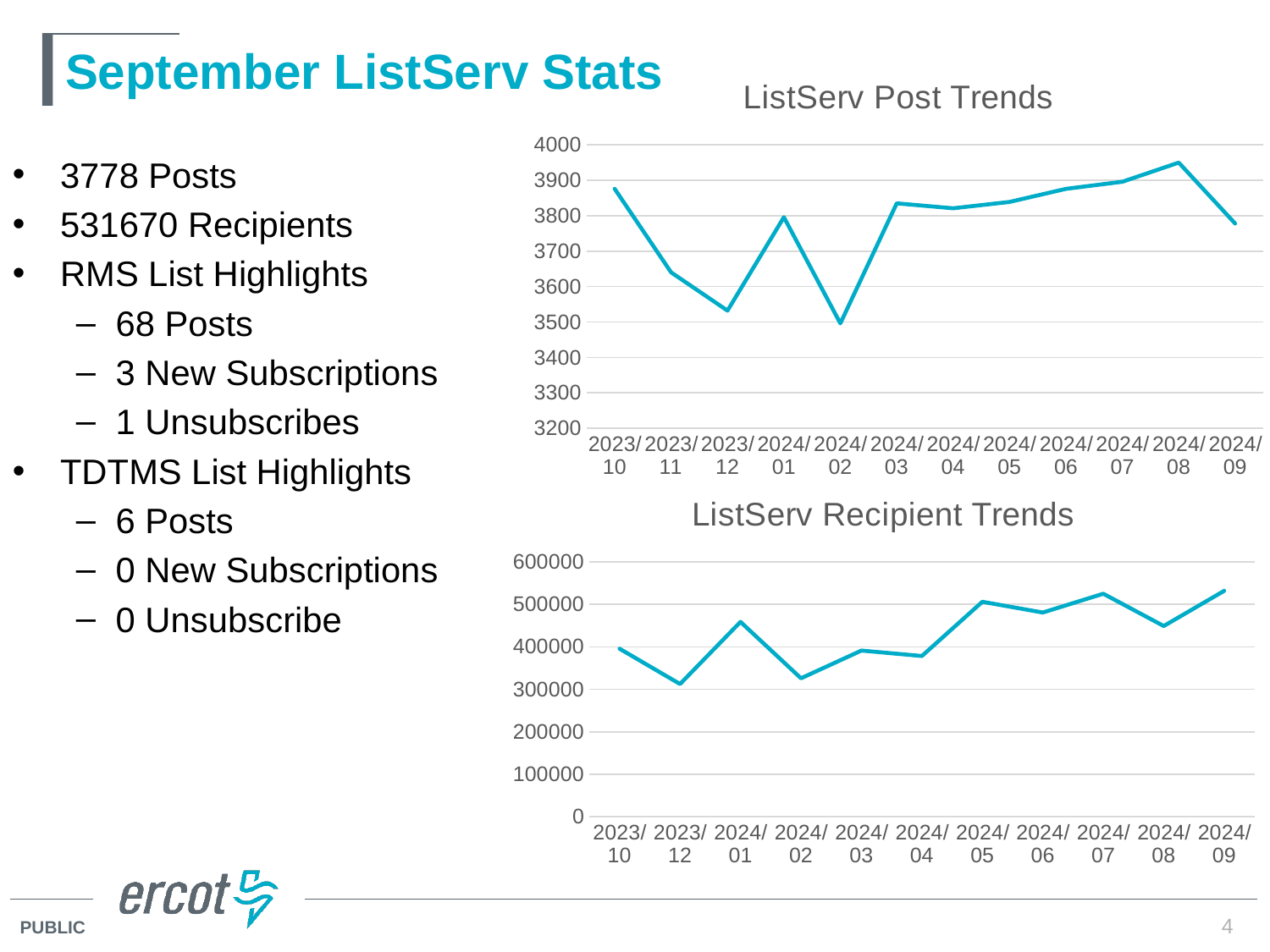
What kind of chart is the ListServ Post Trends chart? line chart In the ListServ Post Trends chart, is the value for 2024/08 greater or less than 3900? greater How many months are plotted on the x axis of the ListServ Post Trends chart? 12 In the ListServ Post Trends chart, which month has the highest value? 2024/08 In the ListServ Recipient Trends chart, is the value for 2024/07 greater or less than 500000? greater In the ListServ Recipient Trends chart, is the value for 2023/12 greater or less than 400000? less In the ListServ Post Trends chart, do the values rise or fall from 2024/03 to 2024/08? rise In the ListServ Recipient Trends chart, which is larger, the value for 2024/01 or the value for 2024/02? 2024/01 In the ListServ Post Trends chart, which month has the lowest value? 2024/02 In the ListServ Post Trends chart, which is larger, the value for 2023/10 or the value for 2023/11? 2023/10 How many months are plotted on the x axis of the ListServ Recipient Trends chart? 11